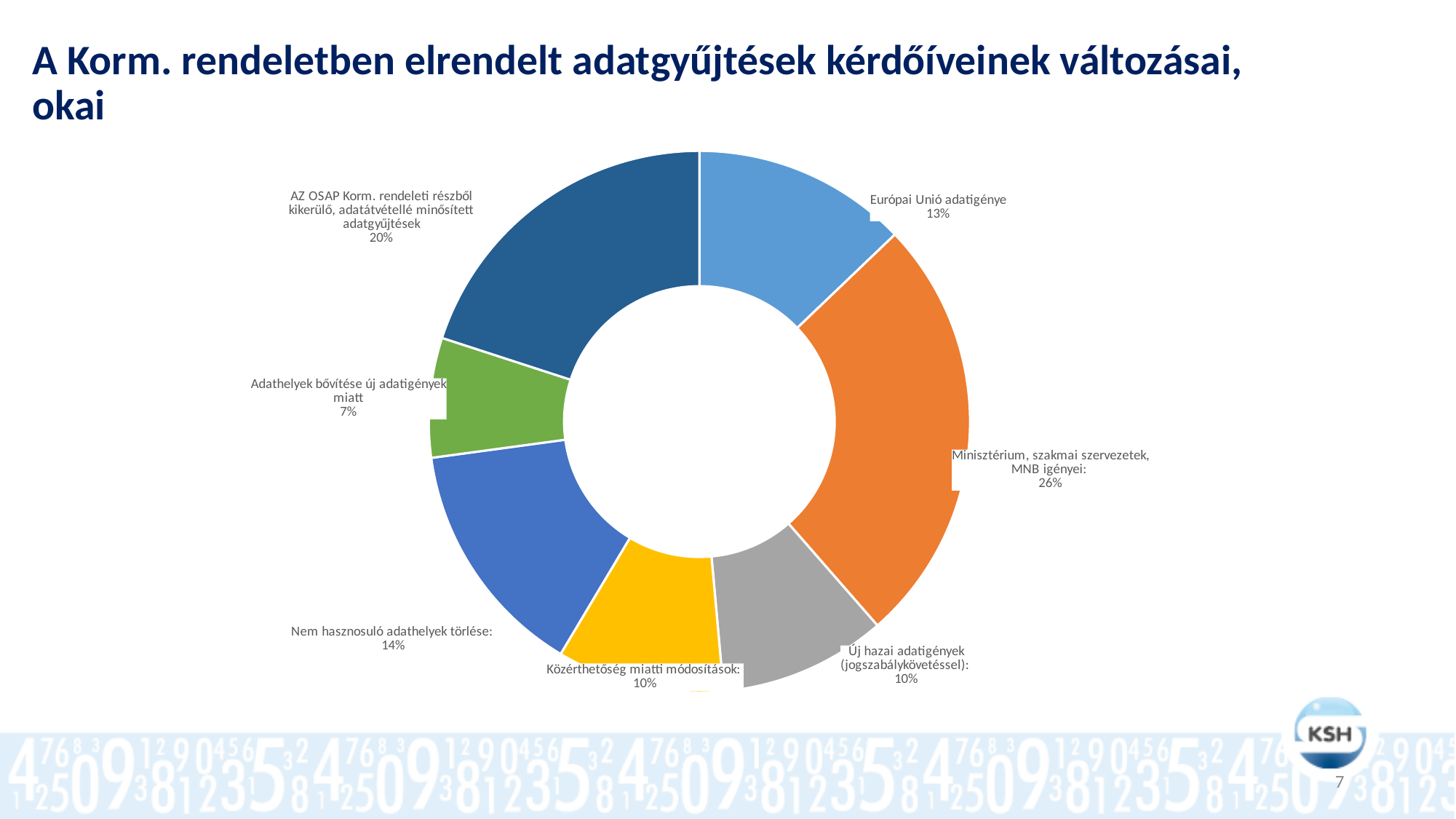
What percentage is shown for 'Adathelyek bővítése új adatigények miatt'? 7% What percentage is shown for 'Nem hasznosuló adathelyek törlése'? 14% What colour is the slice for 'Közérthetőség miatti módosítások'? Yellow Which is larger: the share for 'Nem hasznosuló adathelyek törlése' or the share for 'Európai Unió adatigénye'? Nem hasznosuló adathelyek törlése What kind of chart is shown on the slide? Doughnut (pie) chart What share of the chart is labelled 'Minisztérium, szakmai szervezetek, MNB igényei'? 26% What is the difference in percentage points between 'Minisztérium, szakmai szervezetek, MNB igényei' and 'AZ OSAP Korm. rendeleti részből kikerülő, adatátvétellé minősített adatgyűjtések'? 6 percentage points How many categories (slices) does the chart show? 7 What percentage is shown for 'Európai Unió adatigénye'? 13% Which category has the smallest share of the chart? Adathelyek bővítése új adatigények miatt Which category has the largest share of the chart? Minisztérium, szakmai szervezetek, MNB igényei What is the combined share of 'Új hazai adatigények (jogszabálykövetéssel)' and 'Közérthetőség miatti módosítások'? 20%